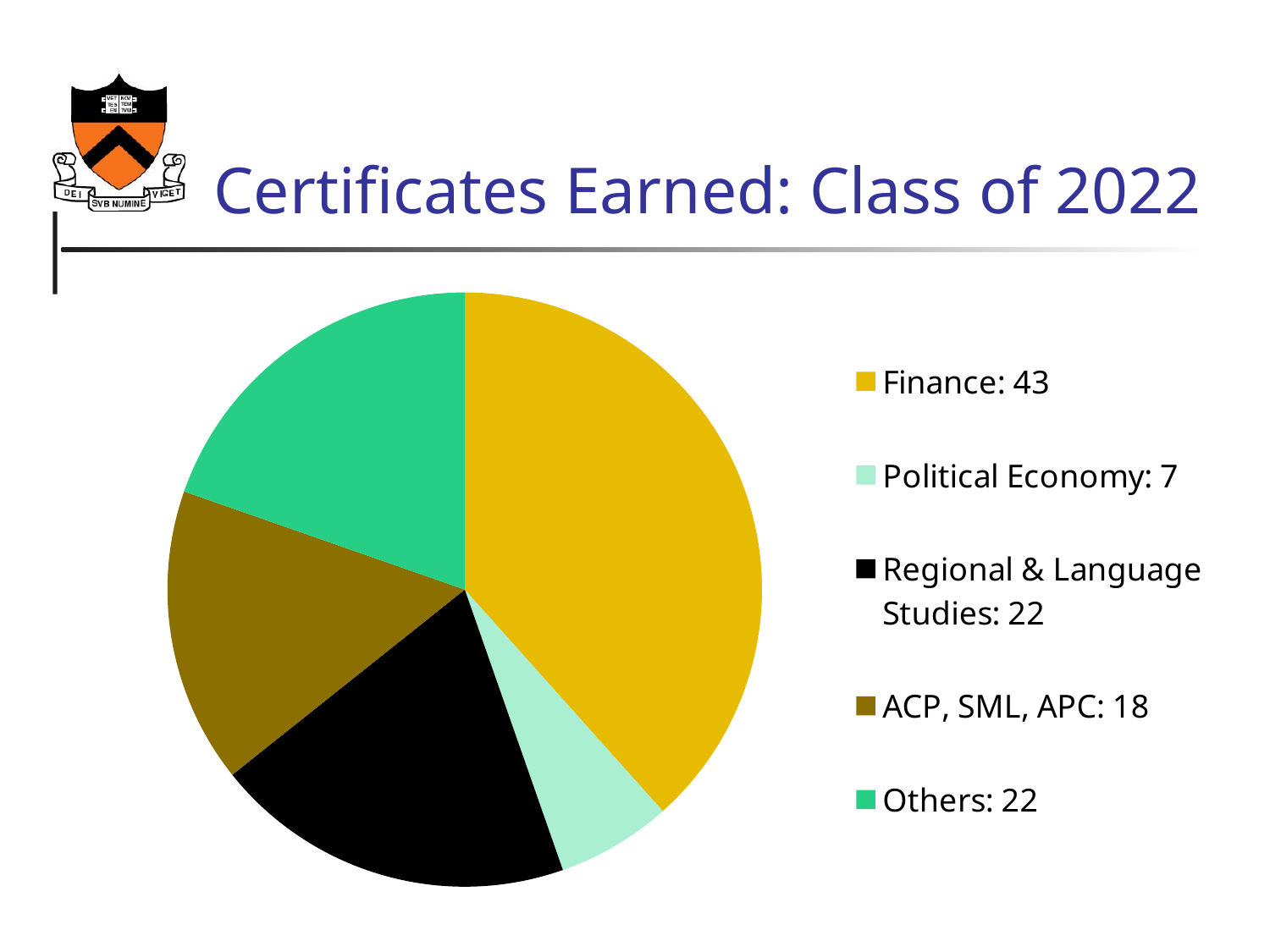
What is the difference between the Finance value and the Political Economy value? 36 What kind of chart is shown on the slide? Pie chart Which is larger, Regional & Language Studies or ACP, SML, APC? Regional & Language Studies How many certificates were earned in Political Economy? 7 How many categories does the pie chart show? 5 Which category has the largest slice of the pie? Finance What is the title of the chart on the slide? Certificates Earned: Class of 2022 What is the total of all the values shown in the legend? 112 What is the value for ACP, SML, APC? 18 What is the value for Regional & Language Studies? 22 Which category has the smallest slice of the pie? Political Economy How many certificates were earned in Finance? 43